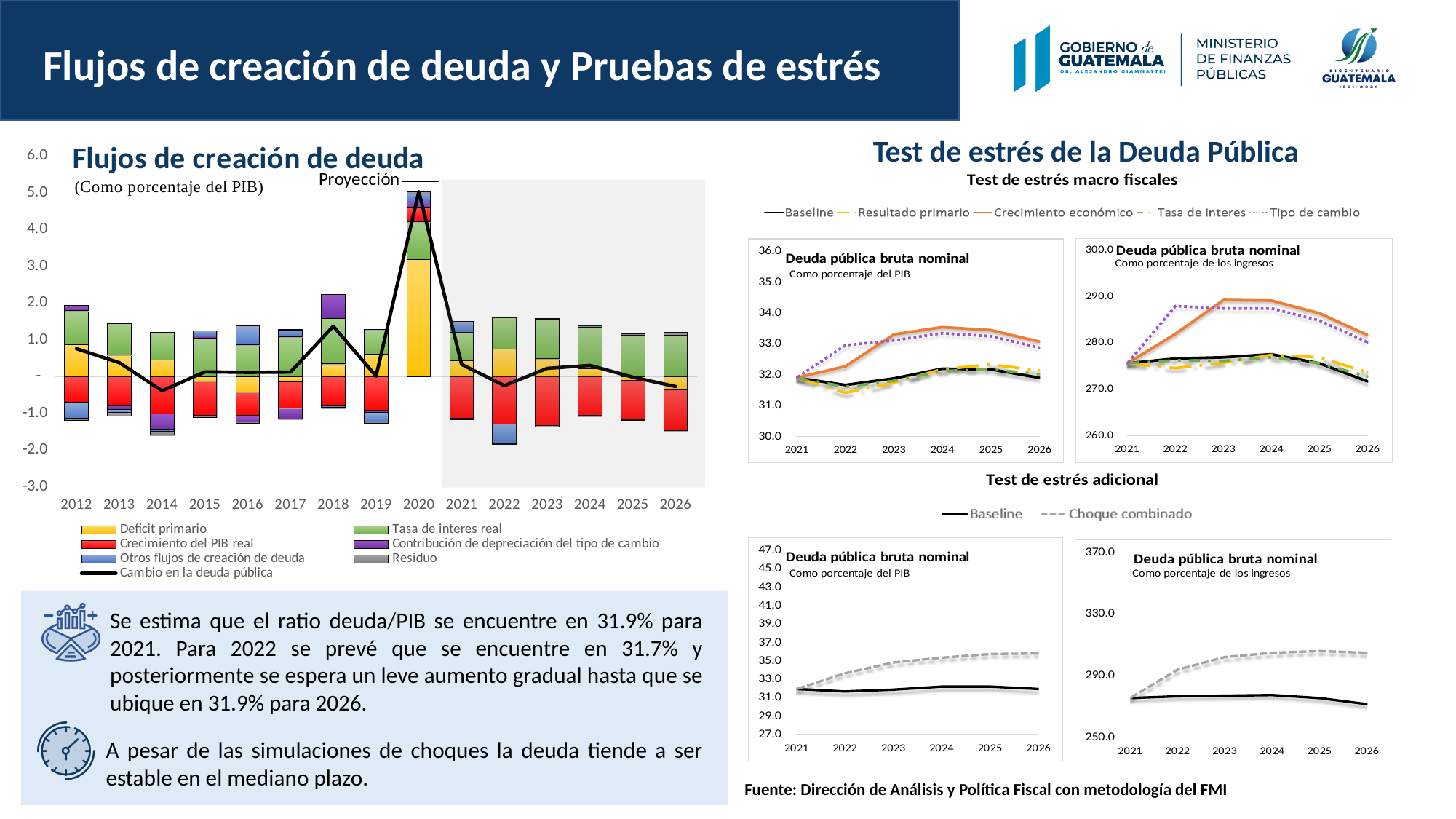
In the 'Flujos de creación de deuda' chart, which year is the first one inside the shaded 'Proyección' area? 2021 In the 'Flujos de creación de deuda' chart, in which year does the 'Cambio en la deuda pública' line reach its highest value? 2020 In the 'Test de estrés adicional' chart 'Deuda pública bruta nominal, Como porcentaje del PIB', which series is larger in 2026, 'Baseline' or 'Choque combinado'? Choque combinado In the 'Test de estrés macro fiscales' chart 'Deuda pública bruta nominal, Como porcentaje de los ingresos', is the 'Crecimiento económico' value for 2023 greater or less than 280.0? greater In the 'Flujos de creación de deuda' chart, is the 'Cambio en la deuda pública' value for 2020 greater or less than 4.0? greater What kind of chart is the 'Flujos de creación de deuda' chart on the left of the slide? Stacked bar chart with a line In the 'Test de estrés adicional' chart 'Deuda pública bruta nominal, Como porcentaje de los ingresos', is the 'Choque combinado' value for 2026 greater or less than 290.0? greater How many years are shown on the x axis of the 'Flujos de creación de deuda' chart? 15 How many series does the legend of the 'Test de estrés adicional' charts list? 2 How many series does the legend of the 'Flujos de creación de deuda' chart list? 7 How many series does the legend of the 'Test de estrés macro fiscales' charts list? 5